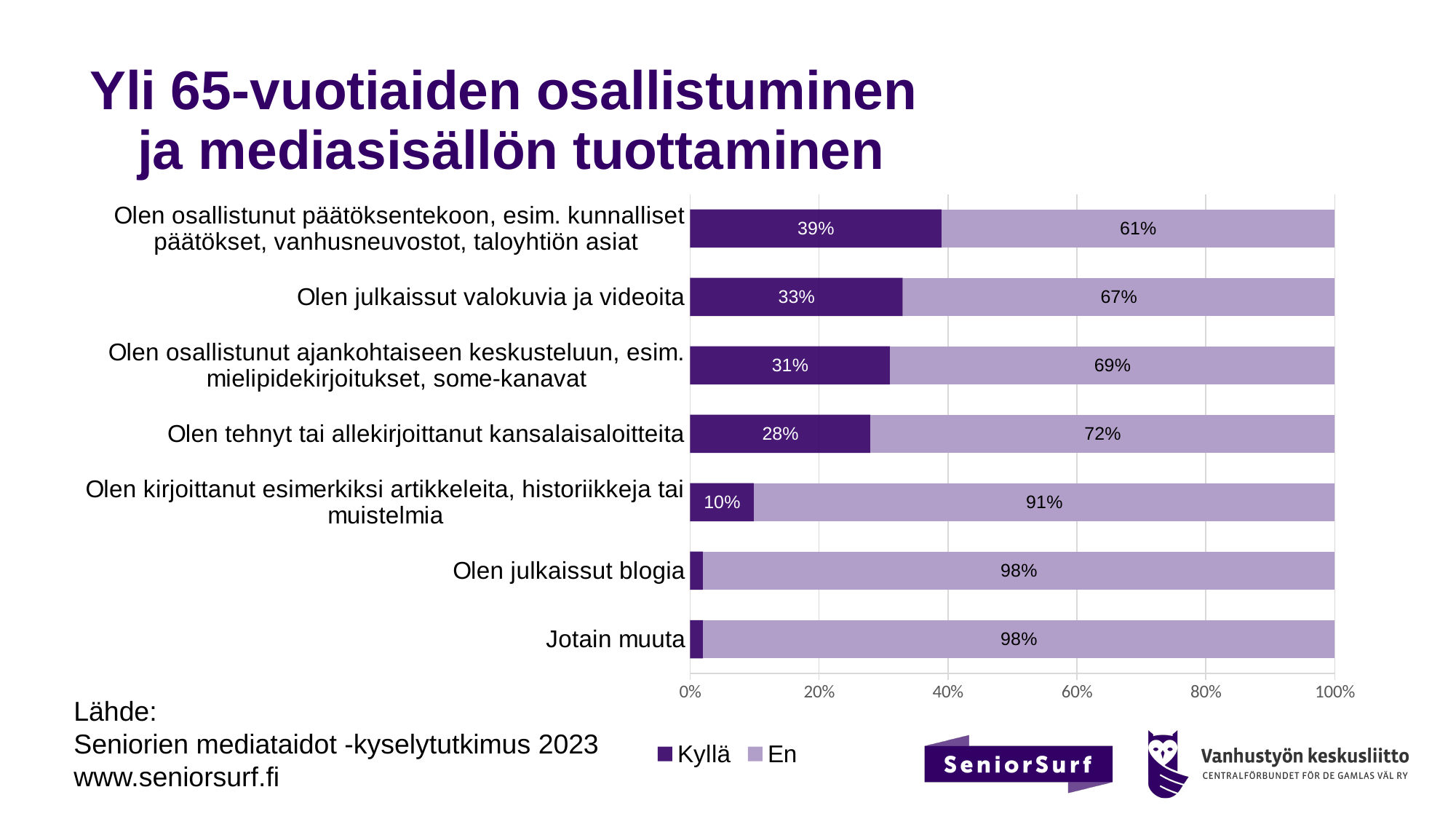
How many categories are shown in the chart? 7 What is the Kyllä value for "Olen kirjoittanut esimerkiksi artikkeleita, historiikkeja tai muistelmia"? 10% Which has a larger Kyllä share: "Olen tehnyt tai allekirjoittanut kansalaisaloitteita" or "Olen osallistunut ajankohtaiseen keskusteluun"? Olen osallistunut ajankohtaiseen keskusteluun Is the Kyllä value for "Olen julkaissut valokuvia ja videoita" greater or less than 40%? less Which category has the highest Kyllä share? Olen osallistunut päätöksentekoon, esim. kunnalliset päätökset, vanhusneuvostot, taloyhtiön asiat How many series does the legend list? 2 What kind of chart is shown on the slide? Stacked horizontal bar chart Which category has the lowest En share? Olen osallistunut päätöksentekoon, esim. kunnalliset päätökset, vanhusneuvostot, taloyhtiön asiat What is the En value for "Olen julkaissut blogia"? 98% What percentage answered Kyllä for "Olen osallistunut päätöksentekoon, esim. kunnalliset päätökset, vanhusneuvostot, taloyhtiön asiat"? 39% What is the difference in percentage points between the Kyllä values for "Olen osallistunut päätöksentekoon" and "Olen julkaissut valokuvia ja videoita"? 6 percentage points What percentage answered En for "Olen julkaissut valokuvia ja videoita"? 67%